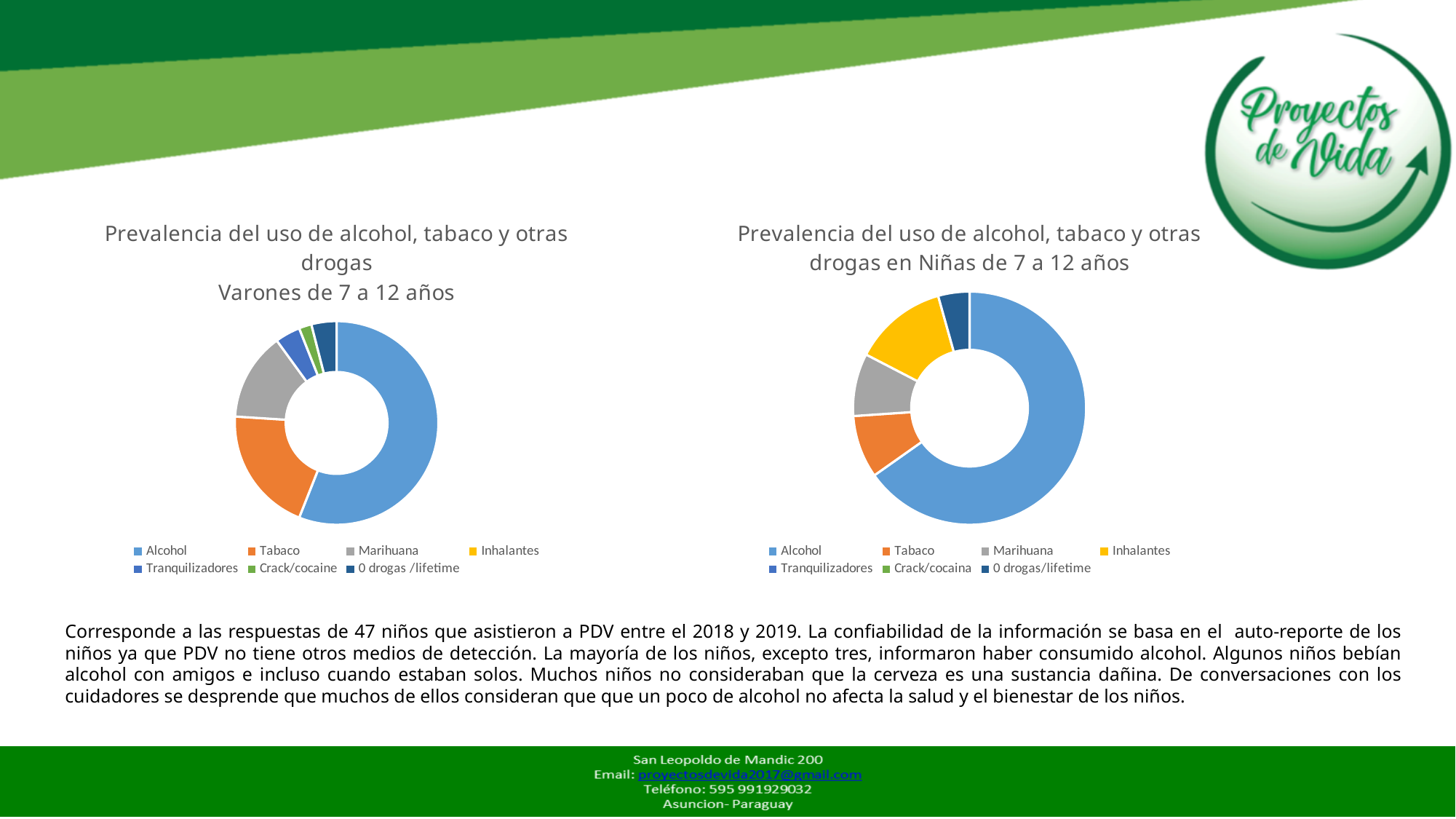
In the left chart (Varones de 7 a 12 años), which slice is larger, Tabaco or Marihuana? Tabaco How many categories does the legend of the right chart (Niñas de 7 a 12 años) list? 7 What is the title of the right chart? Prevalencia del uso de alcohol, tabaco y otras drogas en Niñas de 7 a 12 años How many categories does the legend of the left chart (Varones de 7 a 12 años) list? 7 What colour represents Alcohol in both charts? Blue What kind of chart is the right chart, 'Prevalencia del uso de alcohol, tabaco y otras drogas en Niñas de 7 a 12 años'? Pie (doughnut) chart In the right chart (Niñas de 7 a 12 años), which category has the largest slice? Alcohol In the left chart (Varones de 7 a 12 años), which slice is larger, Marihuana or Tranquilizadores? Marihuana In the right chart (Niñas de 7 a 12 años), which slice is larger, Inhalantes or Tabaco? Inhalantes In the left chart (Varones de 7 a 12 años), which category has the largest slice? Alcohol What kind of chart is the left chart, 'Prevalencia del uso de alcohol, tabaco y otras drogas Varones de 7 a 12 años'? Pie (doughnut) chart